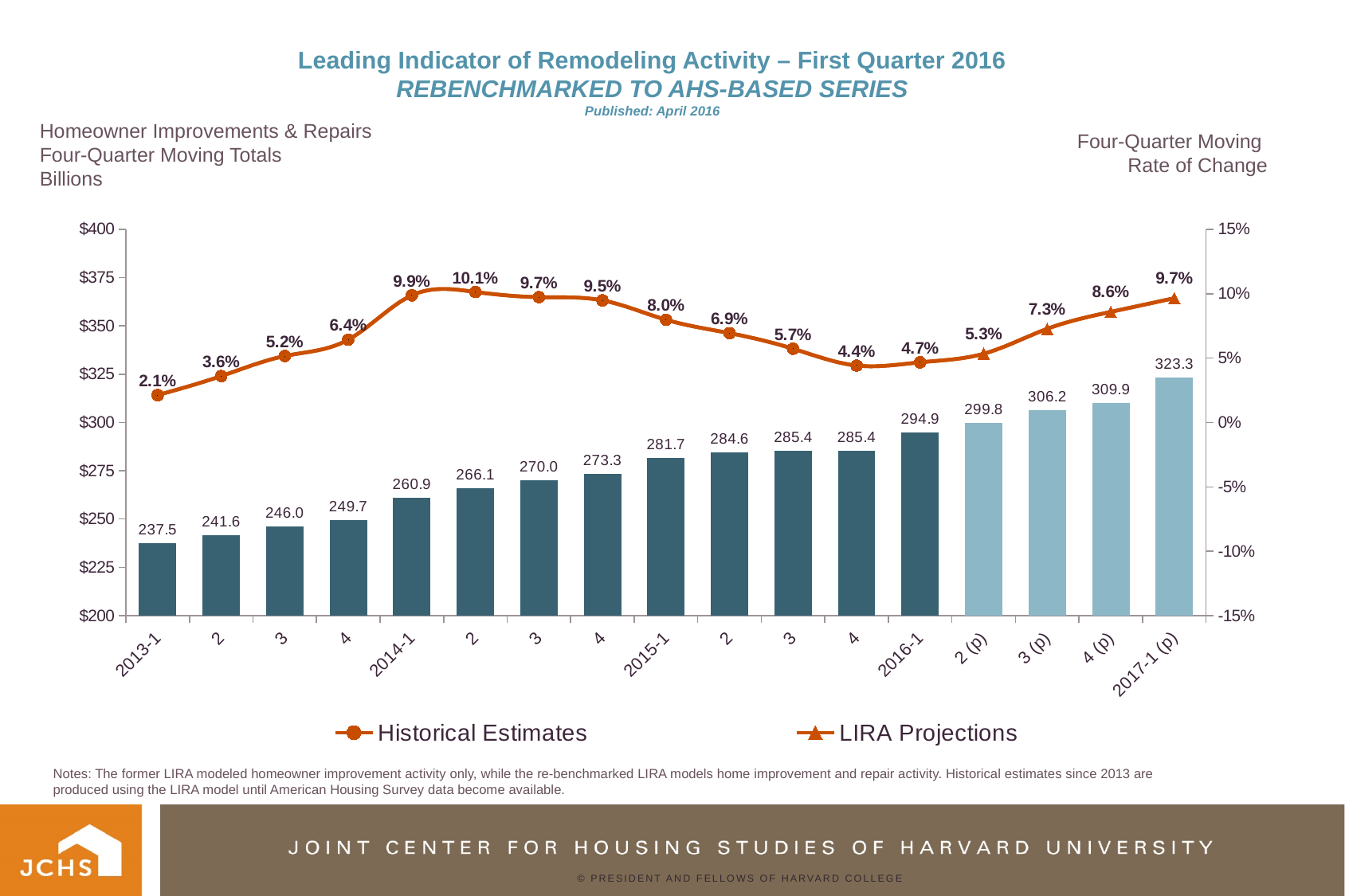
What is the difference between the four-quarter moving totals for 2017-1 (p) and 2016-1? 28.4 Which period has the lowest four-quarter moving total? 2013-1 What is the four-quarter moving total for 2016-1? 294.9 Which is larger, the rate of change for 2015-1 or for 2016-2 (p)? 2015-1 Which period has the highest four-quarter moving rate of change? 2014-2 How many series does the legend list? 2 What kinds of chart are combined on this slide? Bar chart and line chart Do the four-quarter moving totals rise or fall from 2013-1 to 2017-1 (p)? Rise What is the four-quarter moving rate of change for 2014-2? 10.1% What are the two legend entries on the chart? Historical Estimates and LIRA Projections How many periods are shown on the x axis? 17 What is the projected four-quarter moving total for 2017-1 (p)? 323.3